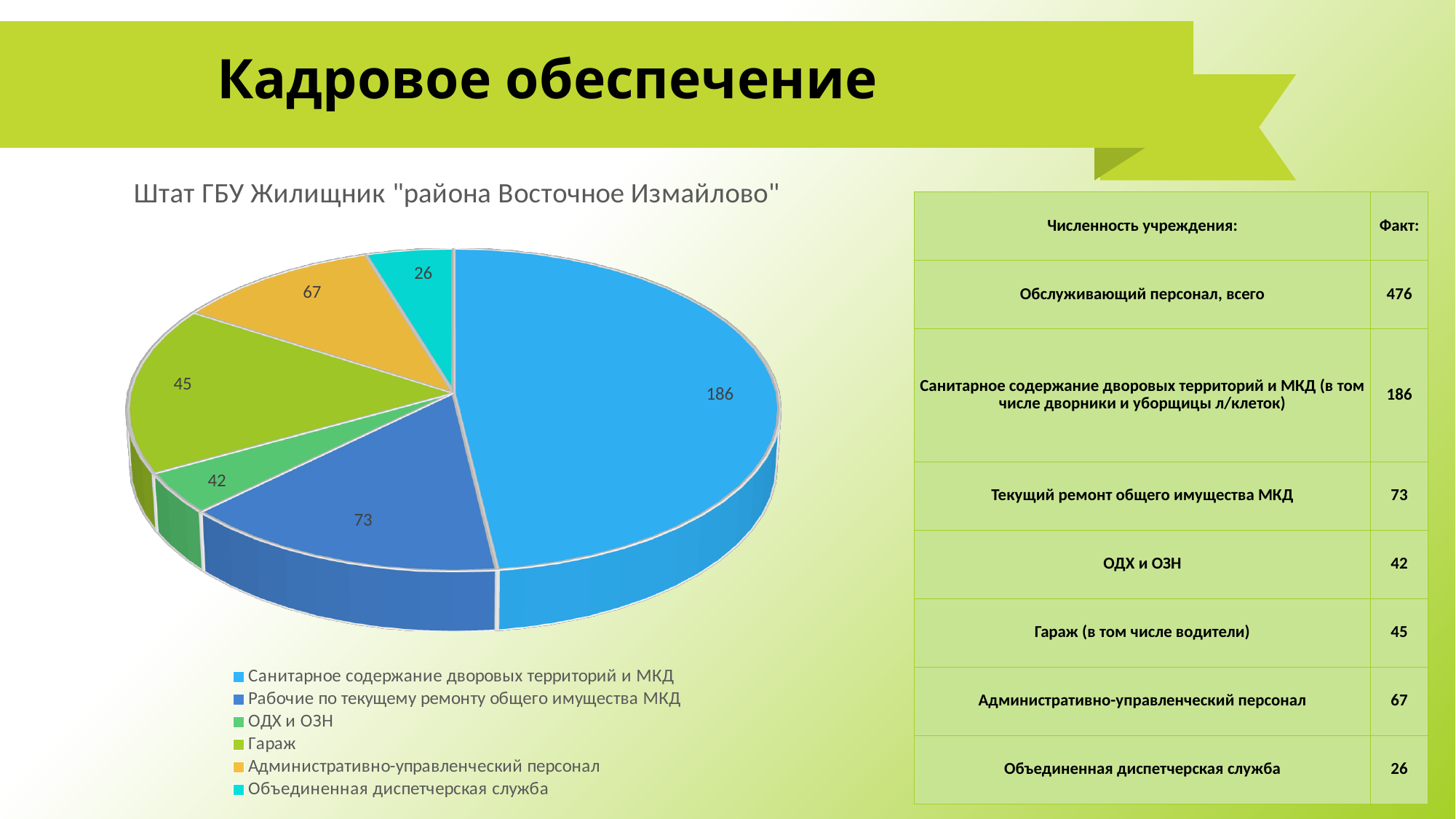
What is the value for Санитарное содержание дворовых территорий и МКД in the pie chart? 186 Which category has the largest slice in the pie chart? Санитарное содержание дворовых территорий и МКД Which is larger in the pie chart: Гараж or ОДХ и ОЗН? Гараж What is the difference between the values for Административно-управленческий персонал and ОДХ и ОЗН? 25 What kind of chart is shown on the slide? Pie chart What colour is the slice for Административно-управленческий персонал? Yellow What is the value for Объединенная диспетчерская служба in the pie chart? 26 How many slices does the pie chart have? 6 What is the value for Гараж in the pie chart? 45 What is the title of the chart? Штат ГБУ Жилищник "района Восточное Измайлово" What is the difference between the values for Санитарное содержание дворовых территорий и МКД and Рабочие по текущему ремонту общего имущества МКД? 113